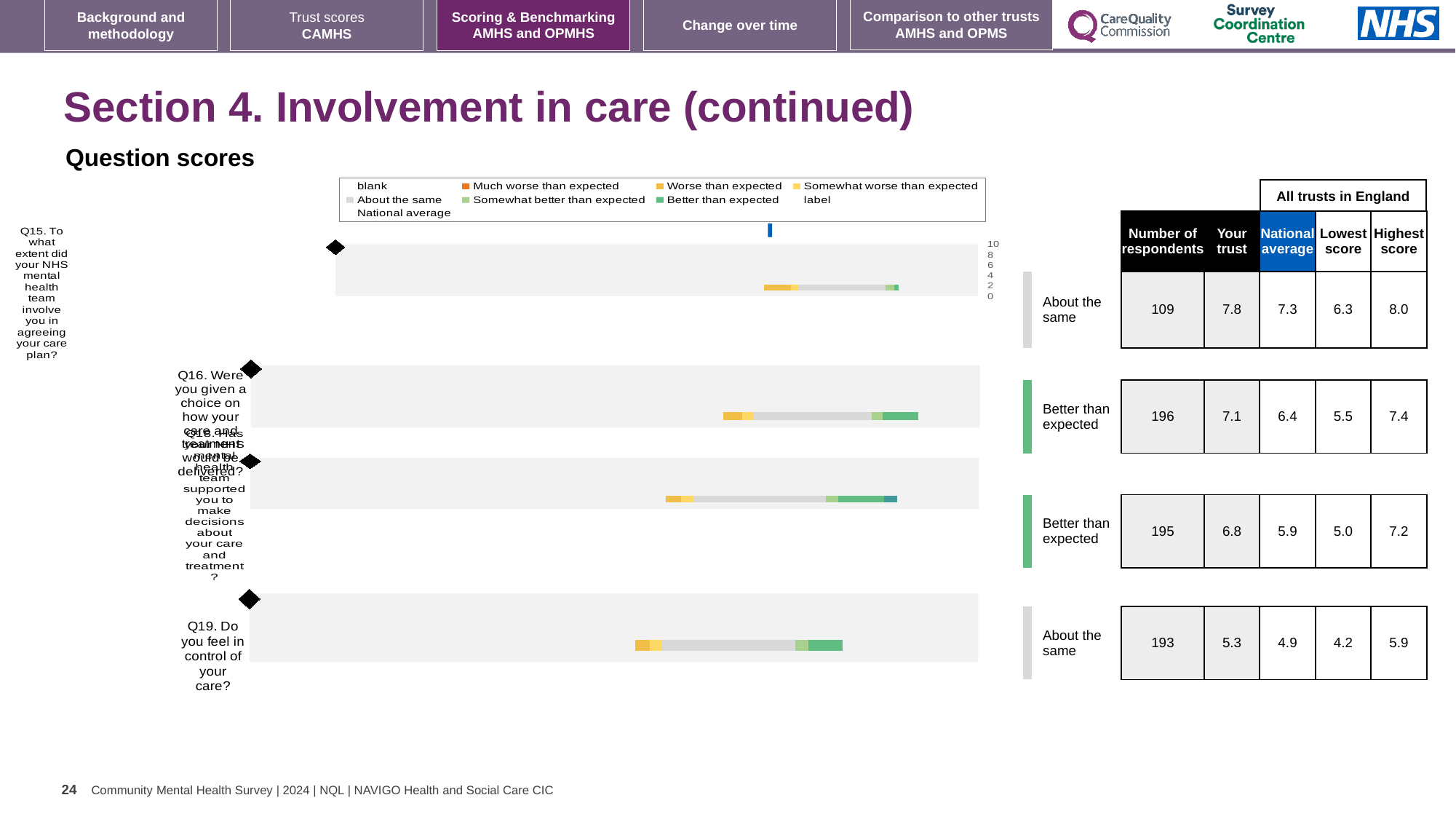
How many respondents answered Q18? 195 What kind of chart is used to show the question scores on this slide? bar chart What is the highest score across all trusts in England for Q16? 7.4 Which question has the highest 'Your trust' score? Q15 What is the national average score for Q19 (feeling in control of your care)? 4.9 What benchmark category is shown for Q16 (choice on how care and treatment would be delivered)? Better than expected How many questions (categories) are plotted in the question scores chart? 4 What is the difference between the 'Your trust' score and the national average for Q15? 0.5 Which question has the lowest 'Your trust' score? Q19 Which has the higher 'Your trust' score, Q16 or Q18? Q16 Which question has the most respondents? Q16 What is the 'Your trust' score for Q15 (involving you in agreeing your care plan)? 7.8